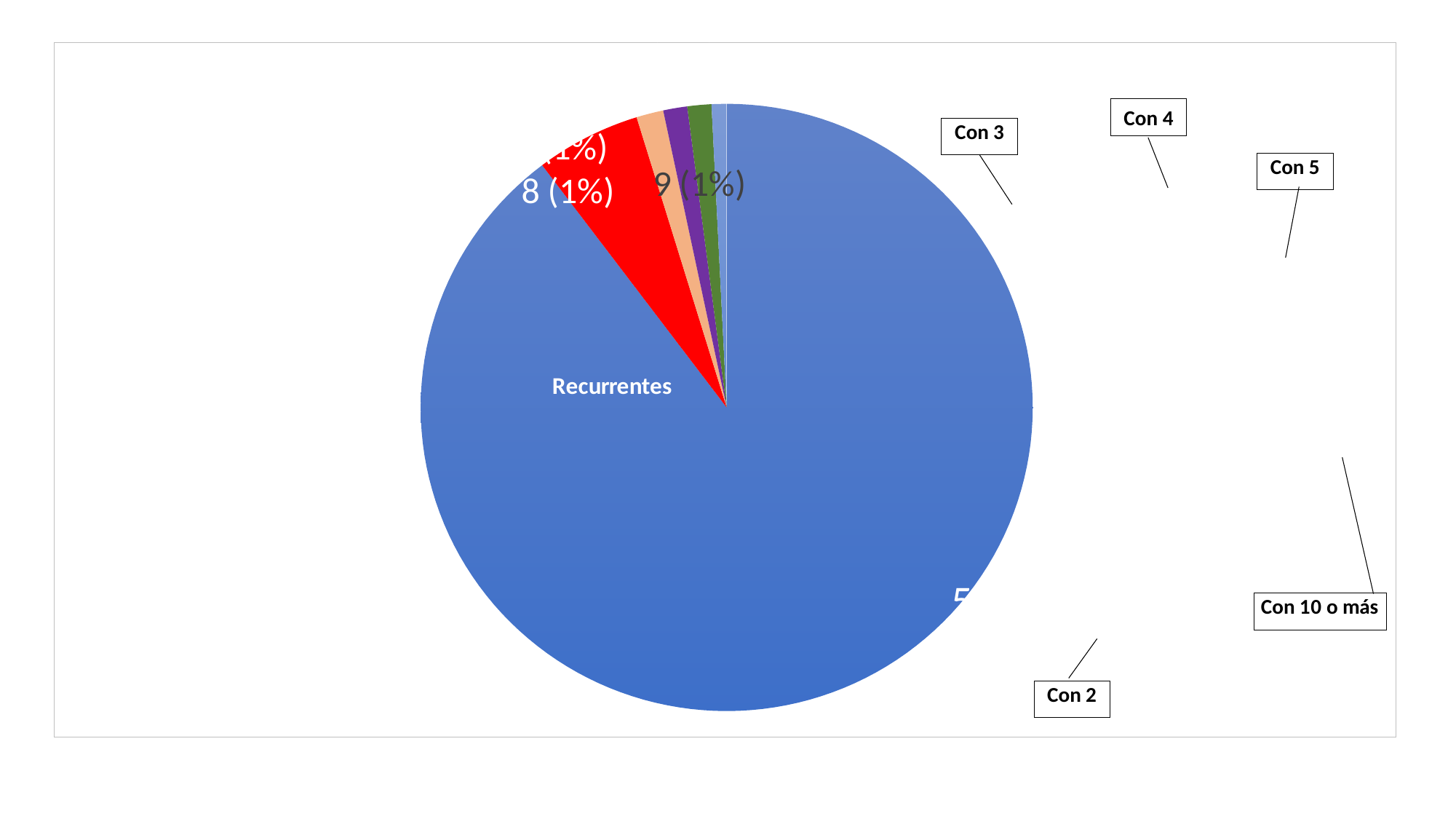
Is the Recurrentes slice greater or less than 50% of the pie? greater What colour is the largest slice of the pie? blue Which category label is printed inside the largest slice? Recurrentes Which category has the largest slice of the pie? Recurrentes Which is larger, the Recurrentes slice or the red slice? Recurrentes What kind of chart is shown on the slide? pie chart